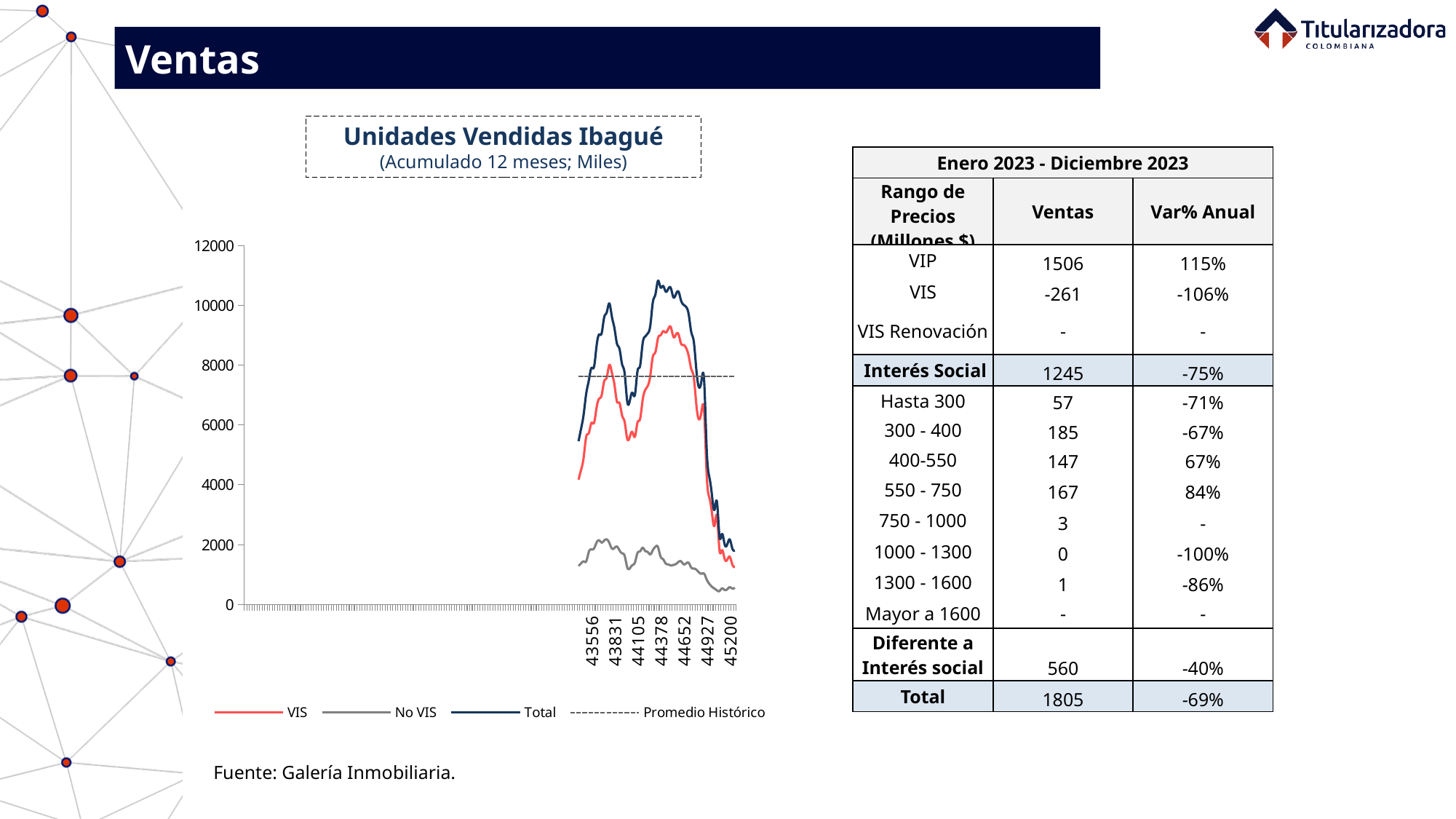
In the "Unidades Vendidas Ibagué" chart, which is larger at the right end of the x axis: the VIS series or the No VIS series? VIS In the "Unidades Vendidas Ibagué" chart, is the No VIS series ever greater than 4000? No, it stays less than 4000 How many series does the legend of the "Unidades Vendidas Ibagué" chart list? 4 What kind of chart is "Unidades Vendidas Ibagué"? Line chart Which series in the "Unidades Vendidas Ibagué" chart stays lowest throughout? No VIS In the "Unidades Vendidas Ibagué" chart, is the peak of the Total series greater or less than 10000? greater In the "Unidades Vendidas Ibagué" chart, do the VIS and Total series rise or fall toward the right end of the x axis? Fall In the "Unidades Vendidas Ibagué" chart, is the Promedio Histórico line greater or less than 8000? less What colour is the Total series in the "Unidades Vendidas Ibagué" chart? Dark blue Which series in the "Unidades Vendidas Ibagué" chart reaches the highest value? Total What is the subtitle shown under the title "Unidades Vendidas Ibagué"? (Acumulado 12 meses; Miles)